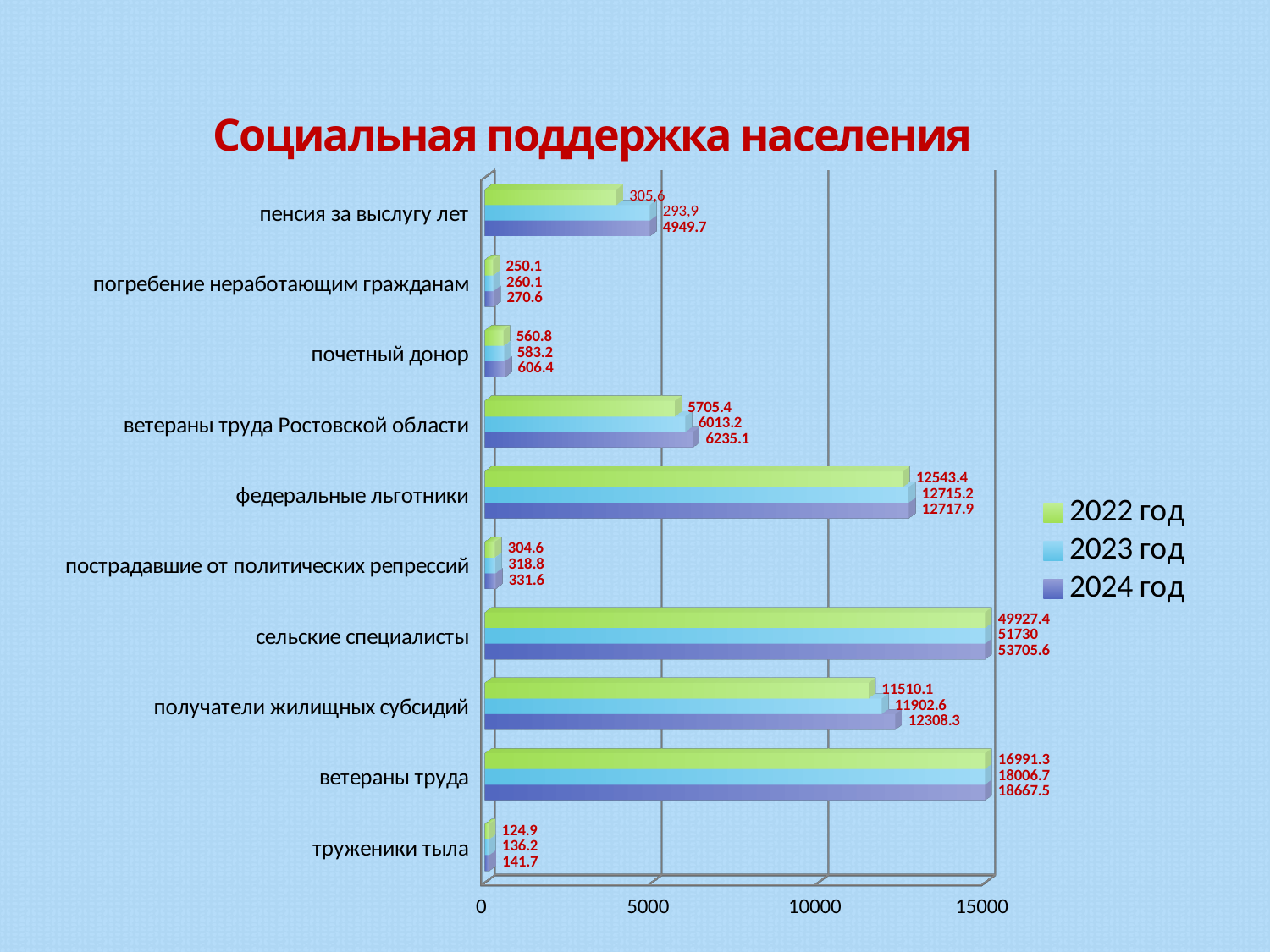
What is the value for ветераны труда in 2022 год? 16991.3 What is the difference between the 2024 год and 2022 год values for получатели жилищных субсидий? 798.2 Do the values for федеральные льготники rise or fall from 2022 год to 2024 год? rise How many series does the legend list? 3 What is the value for сельские специалисты in 2024 год? 53705.6 How many categories are shown on the chart? 10 What type of chart is shown on the slide? bar chart What is the value for почетный донор in 2024 год? 606.4 What is the value for труженики тыла in 2023 год? 136.2 Which category has the lowest value in 2022 год? труженики тыла Which is larger for ветераны труда Ростовской области: the 2023 год value or the 2024 год value? 2024 год Which category has the highest value in 2024 год? сельские специалисты